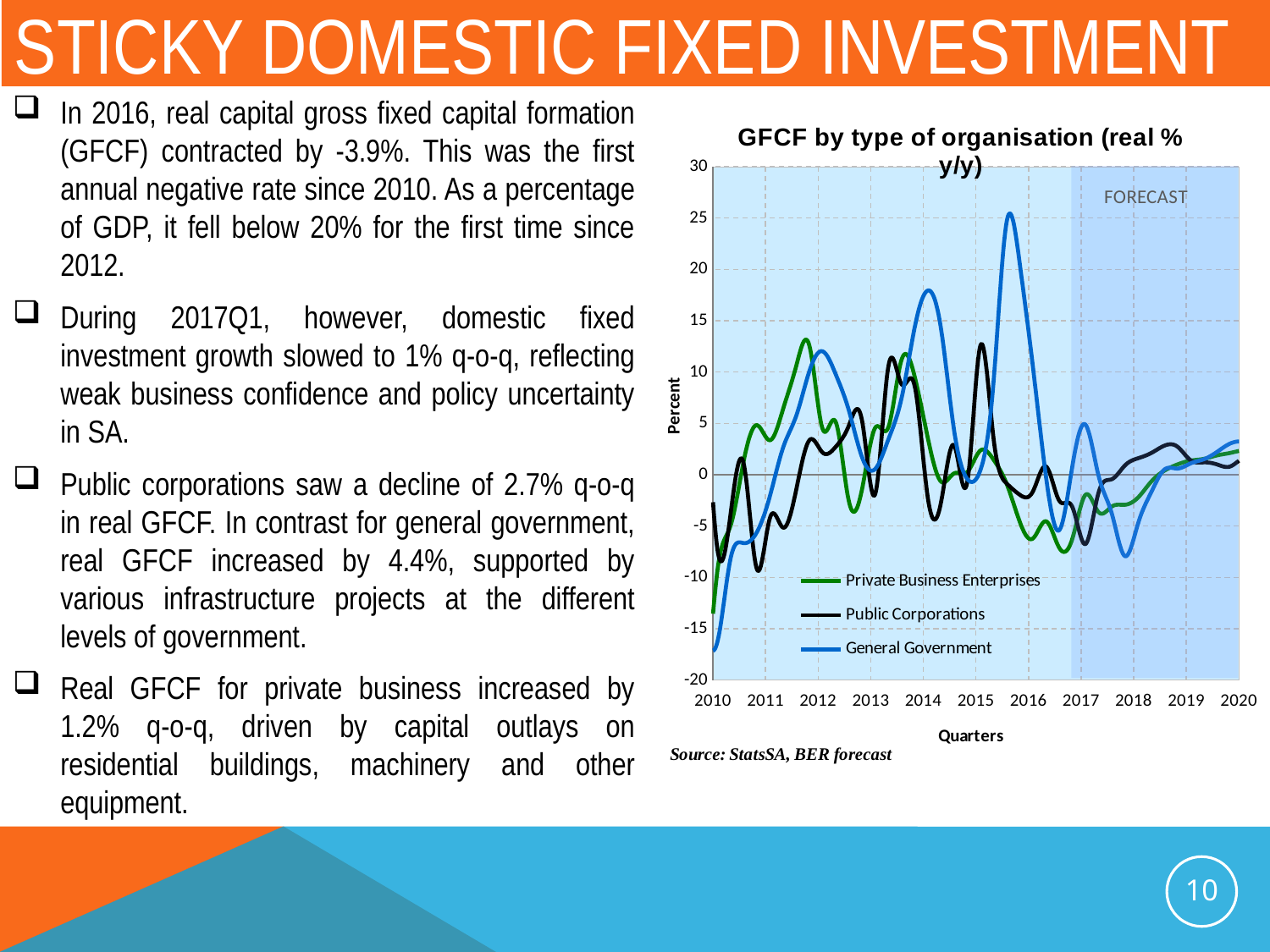
Is the peak value for General Government around 2015-2016 greater or less than 20? greater Which series is higher at the start of 2010, Public Corporations or General Government? Public Corporations Is the peak value for Private Business Enterprises around 2011-2012 greater or less than 10? greater Which series reaches the highest value shown on the chart? General Government Is the value for General Government at the start of 2010 greater or less than -10? less Which series reaches the lowest value shown on the chart? General Government What label is shown on the vertical axis of the chart? Percent What is the title of the chart? GFCF by type of organisation (real % y/y) What kind of chart is shown on the slide? line chart How many series does the chart legend list? 3